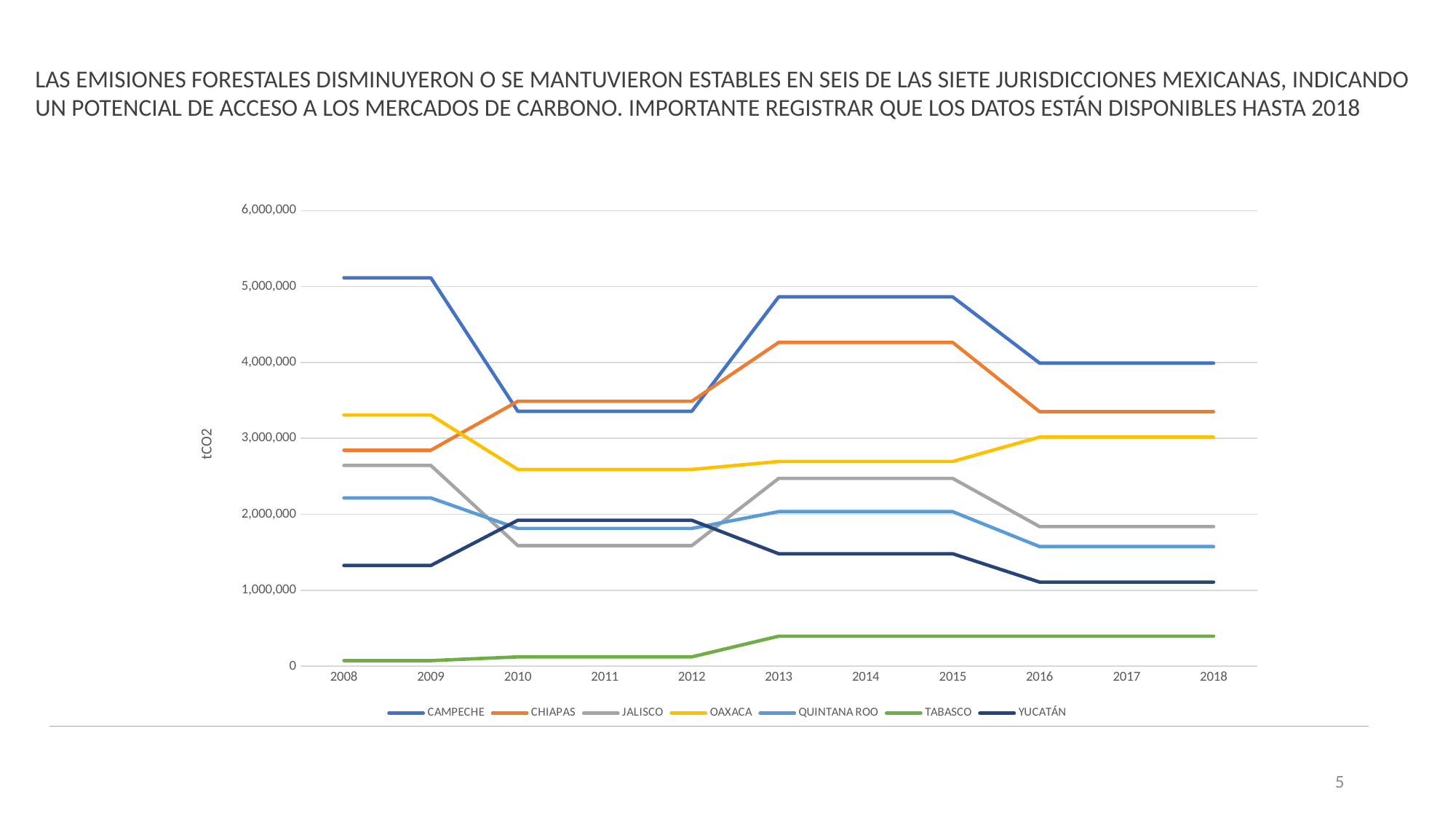
Which jurisdiction has the lowest emissions in 2018? TABASCO What kind of chart is shown on the slide? line chart Which jurisdiction has the highest emissions in 2008? CAMPECHE Is the value for CHIAPAS in 2013 greater or less than 4,000,000? greater Is the value for TABASCO in 2018 greater or less than 1,000,000? less How many years are shown along the x axis? 11 Is the value for YUCATÁN in 2018 greater or less than 2,000,000? less What is the label on the vertical axis? tCO2 How many series does the legend list? 7 In 2018, which is larger, the value for CHIAPAS or the value for OAXACA? CHIAPAS Does the CAMPECHE line rise or fall from 2008 to 2018? fall